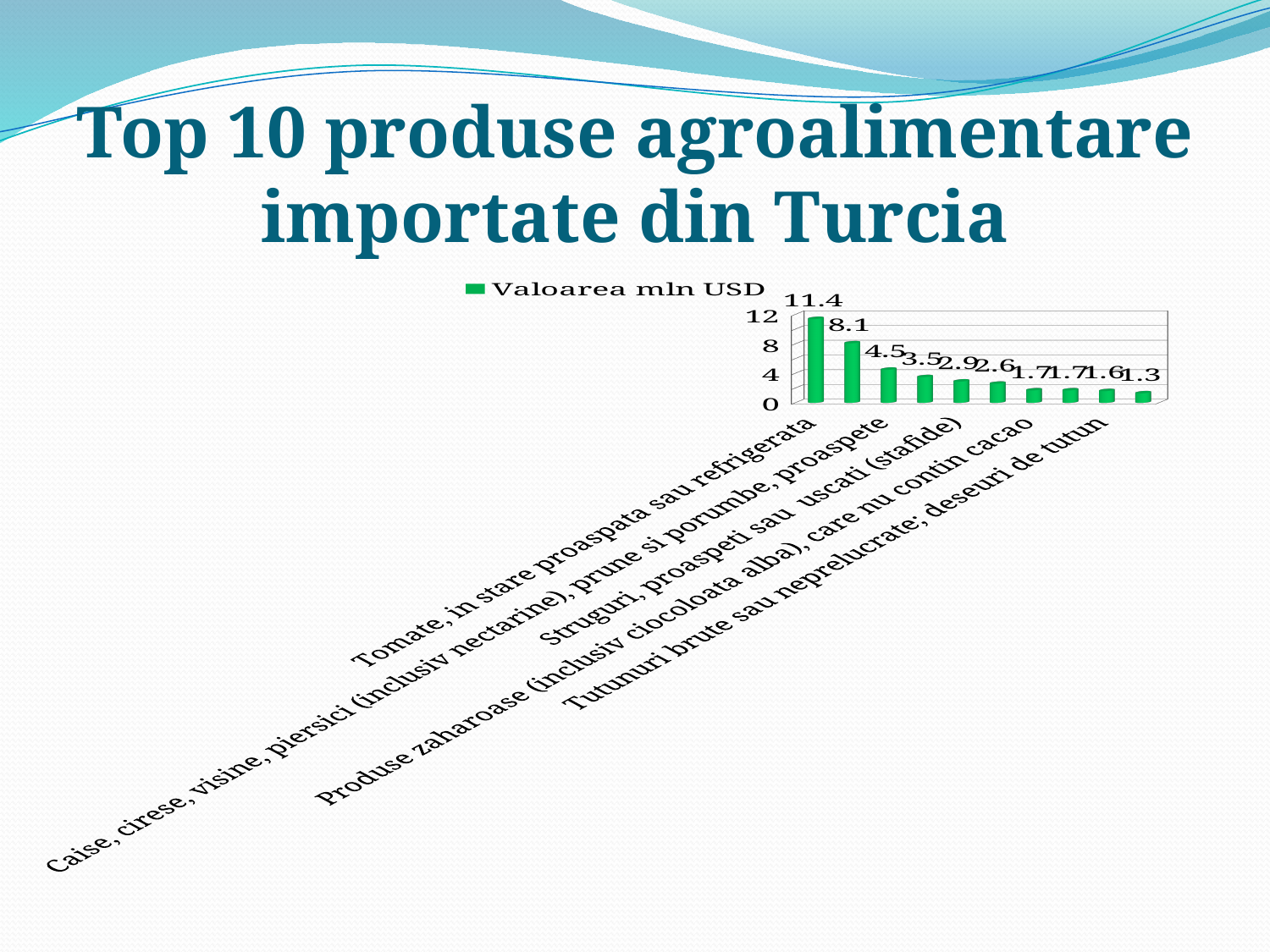
How many bars are plotted in the chart? 10 Do the values rise or fall from left to right along the x axis? fall What is the highest value shown in the chart? 11.4 What is the value for Tomate, in stare proaspata sau refrigerata? 11.4 How many series does the legend list? 1 What is the difference between the highest value (11.4) and the lowest value (1.3)? 10.1 Which category has the highest value in the chart? Tomate, in stare proaspata sau refrigerata What is the difference between the highest value (11.4) and the second highest value (8.1)? 3.3 What is the lowest value shown in the chart? 1.3 What kind of chart is shown on the slide? bar chart What is the legend entry of the chart? Valoarea mln USD Is the value for Tomate, in stare proaspata sau refrigerata greater or less than 8? greater